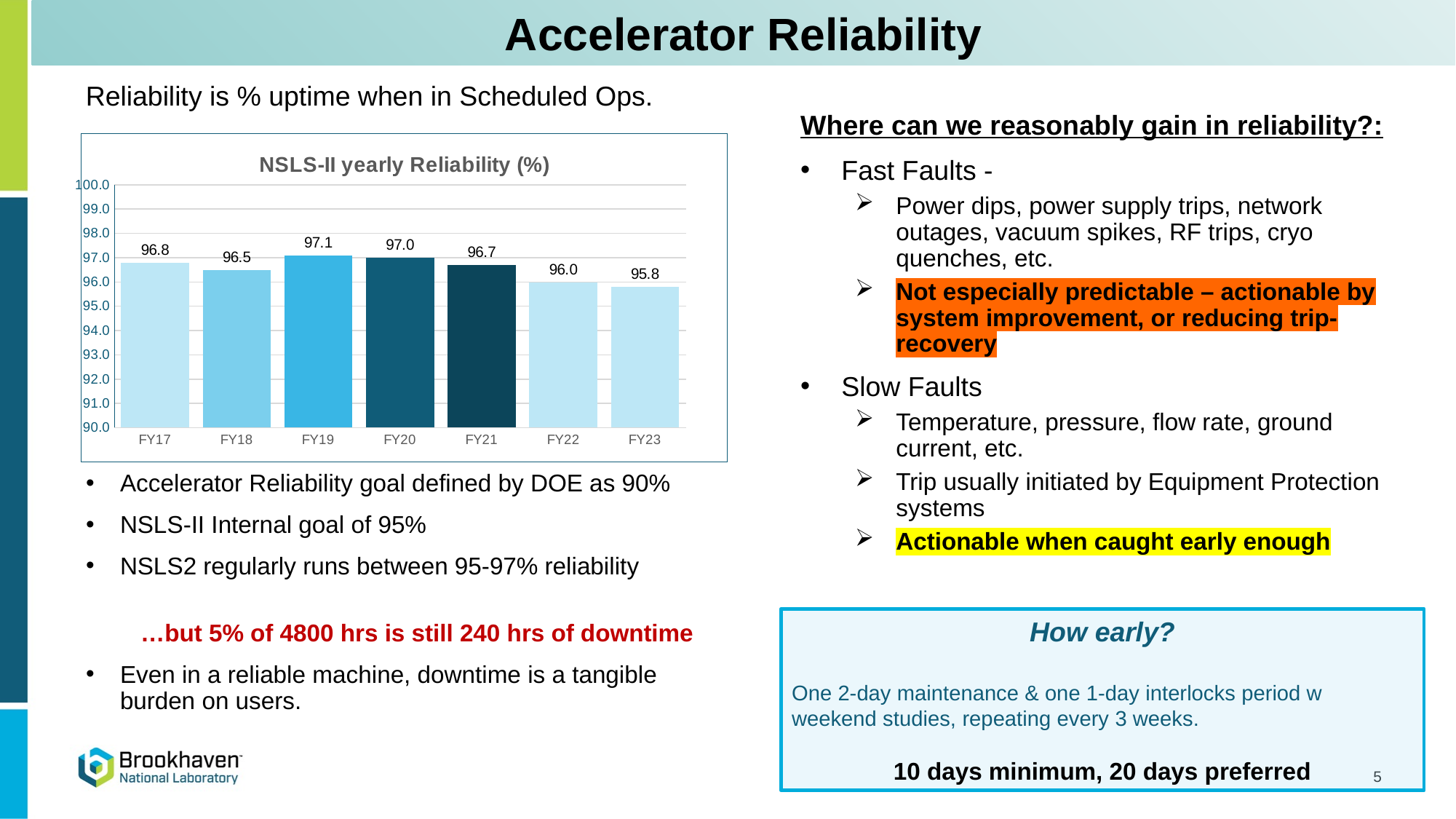
What is the reliability value for FY19? 97.1 Which fiscal year has the lowest reliability? FY23 Which fiscal year has the highest reliability? FY19 How many fiscal years are shown in the chart? 7 What is the reliability value for FY17? 96.8 Which has a higher reliability value, FY18 or FY20? FY20 What is the difference between the reliability values for FY19 and FY23? 1.3 What is the title of the chart? NSLS-II yearly Reliability (%) What is the reliability value for FY23? 95.8 Do the reliability values rise or fall from FY21 to FY23? fall Is the value for FY22 greater or less than 97.0? less What kind of chart is shown on the slide? bar chart